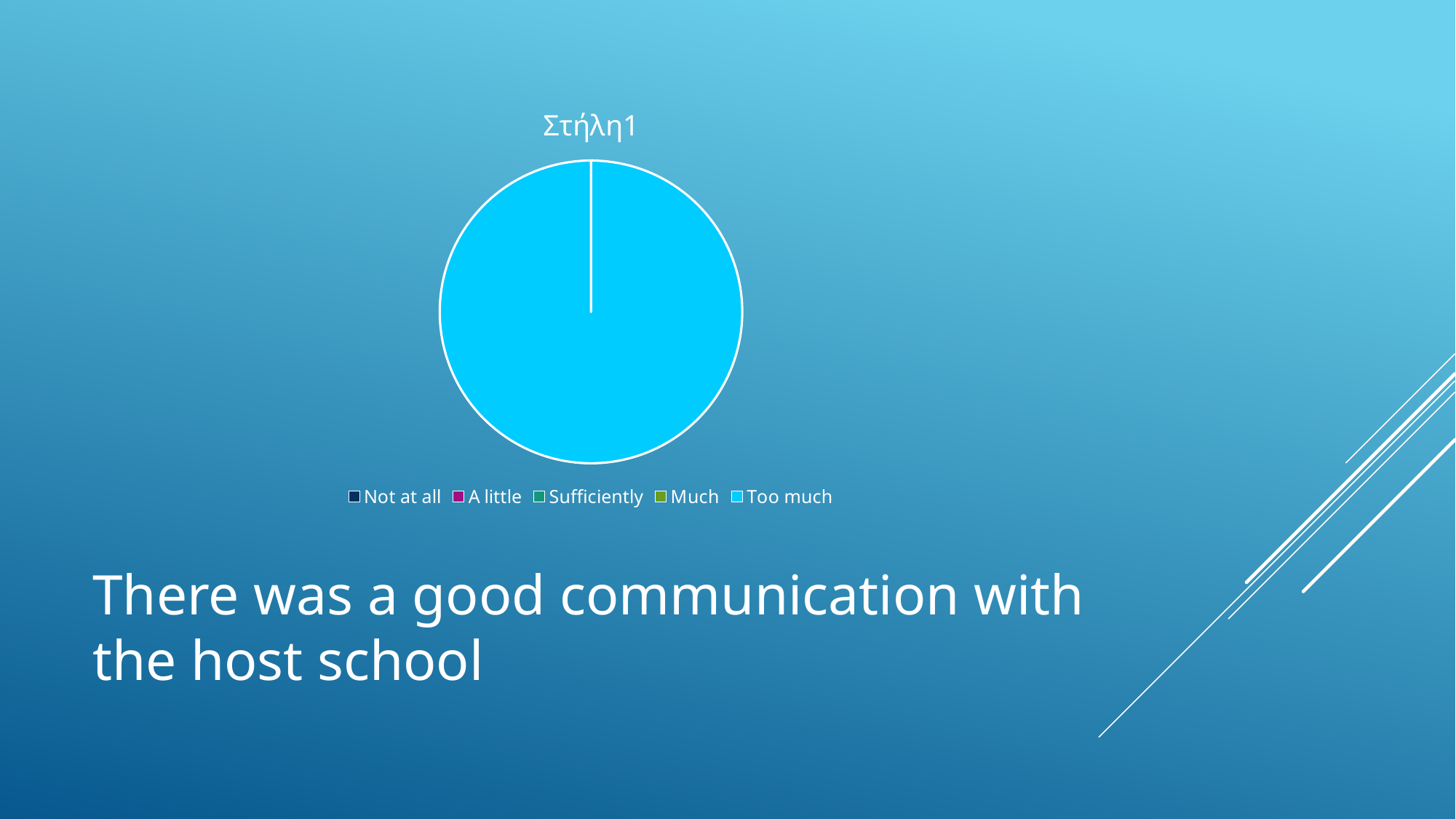
What kind of chart is shown on the slide? pie chart How many categories does the chart's legend list? 5 Which of the two categories, 'Too much' or 'Not at all', has the larger share of the pie? Too much Which of the two categories, 'Much' or 'Too much', has the larger share of the pie? Too much Which category has the largest slice of the pie? Too much What is the title of the chart? Στήλη1 What is the first category listed in the legend? Not at all Which category is represented by the light blue colour in the legend? Too much